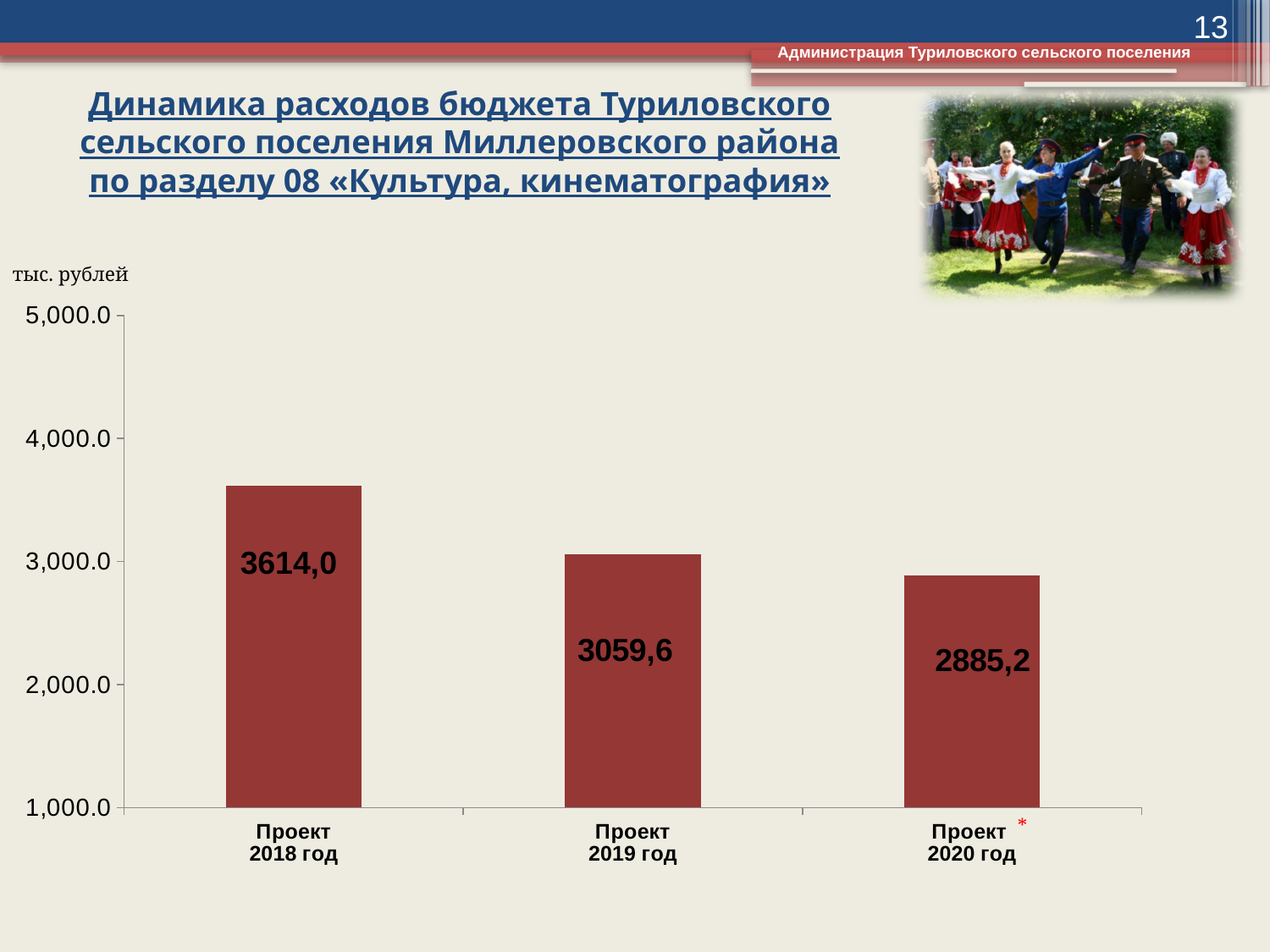
Which category has the lowest value? Проект 2020 год What is the value for Проект 2020 год? 2885,2 How many categories are shown on the chart? 3 What is the difference between the values for Проект 2019 год and Проект 2020 год? 174,4 What is the difference between the values for Проект 2018 год and Проект 2019 год? 554,4 What kind of chart is shown on the slide? bar chart What is the value for Проект 2018 год? 3614,0 Which is larger, the value for Проект 2019 год or Проект 2020 год? Проект 2019 год Do the values rise or fall from Проект 2018 год to Проект 2020 год? fall Which category has the highest value? Проект 2018 год What is the value for Проект 2019 год? 3059,6 Is the value for Проект 2018 год greater or less than 4,000.0? less